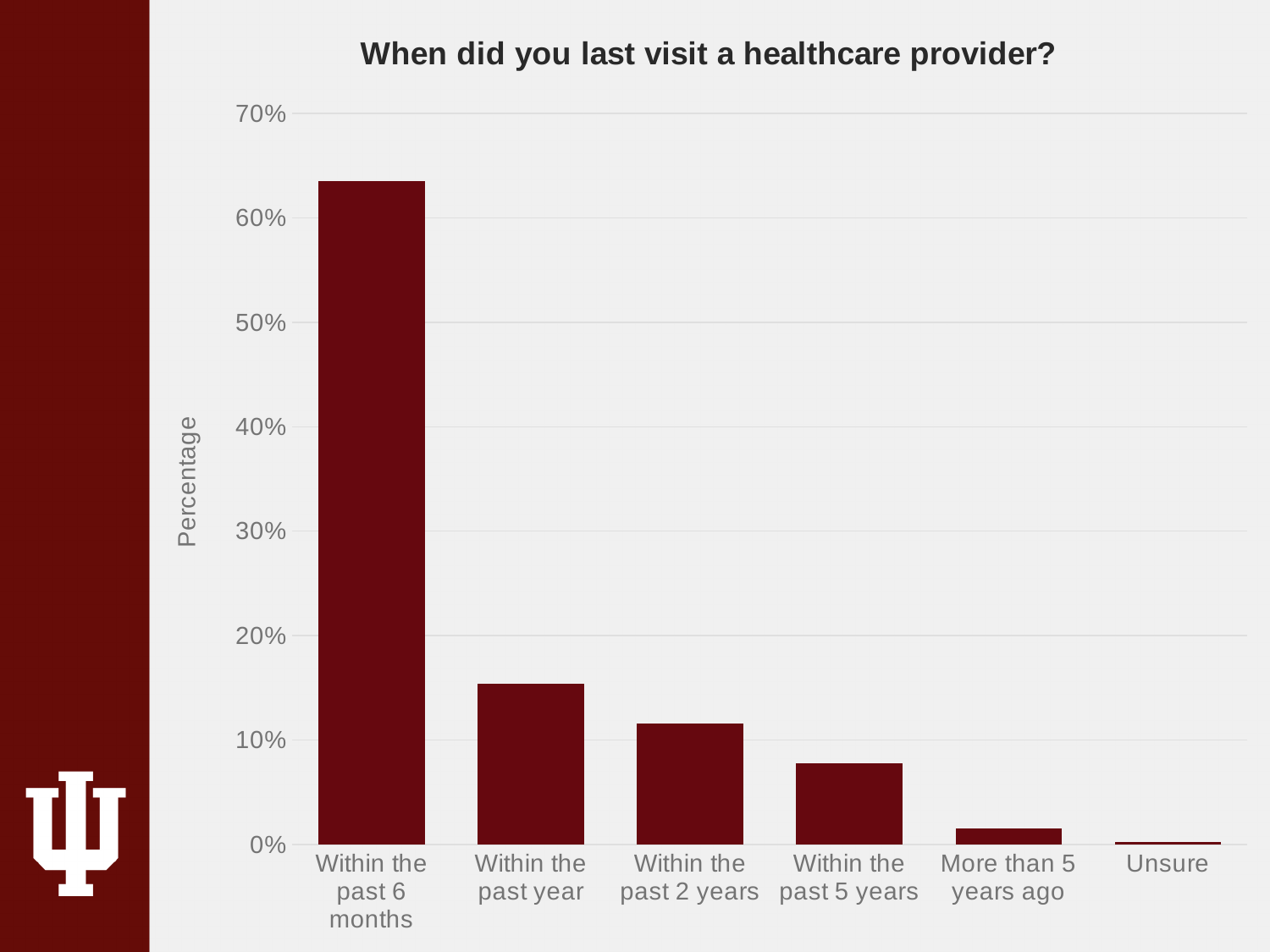
How many categories are shown on the x axis? 6 Which category has the lowest percentage? Unsure Do the values rise or fall moving from left to right along the x axis? fall What is the title of the chart? When did you last visit a healthcare provider? Is the value for 'Within the past 5 years' greater or less than 10%? less Which is larger, the value for 'More than 5 years ago' or the value for 'Within the past 5 years'? Within the past 5 years Which category has the highest percentage? Within the past 6 months Is the value for 'Within the past year' greater or less than 20%? less Is the value for 'Within the past 2 years' greater or less than 10%? greater Which is larger, the value for 'Within the past year' or the value for 'Within the past 2 years'? Within the past year What type of chart is shown on the slide? bar chart